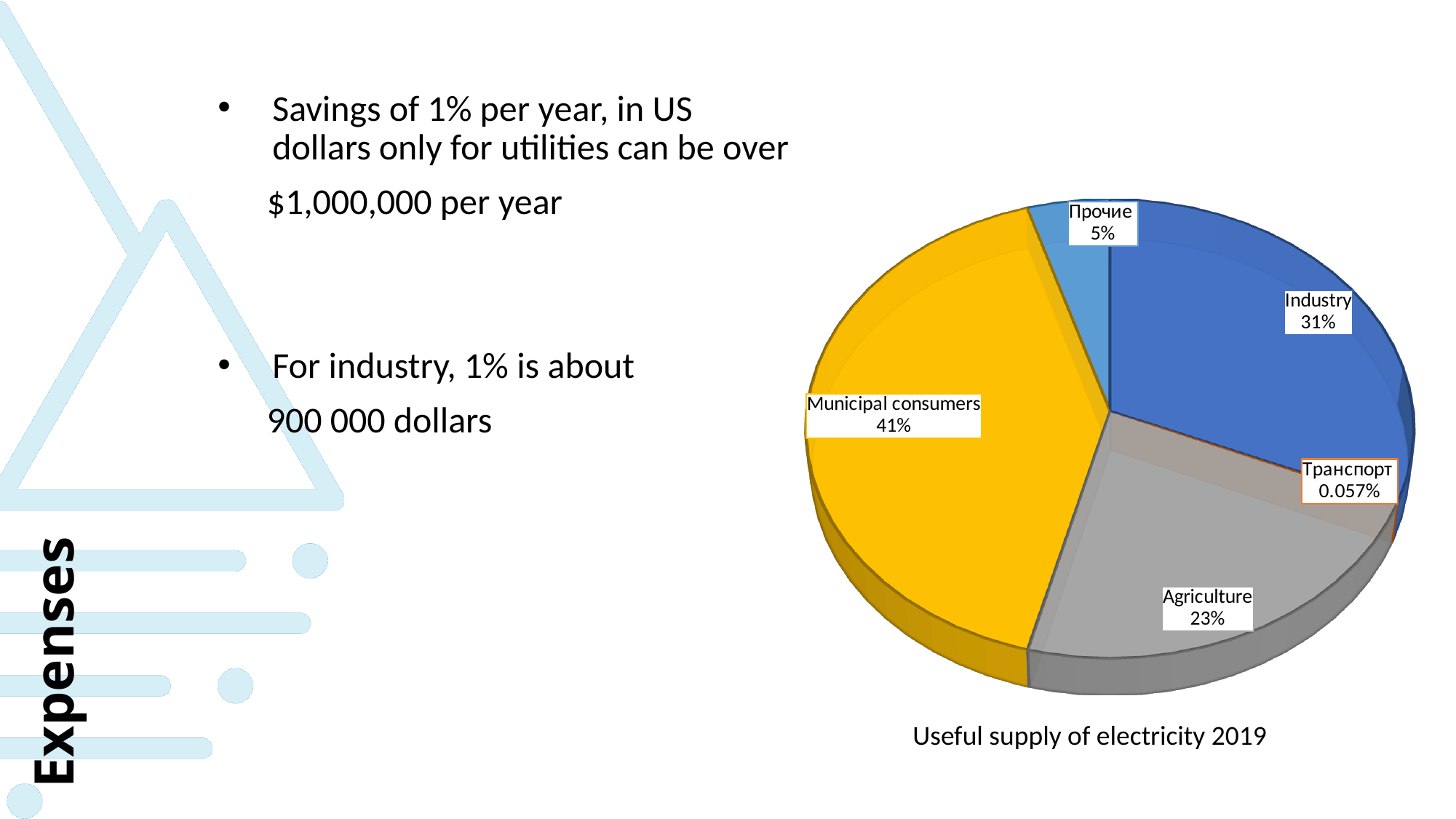
Which is larger, the share for Industry or the share for Agriculture? Industry What is the difference in percentage points between Municipal consumers and Industry? 10 What share of the pie does Прочие have? 5% What kind of chart is shown on the slide? Pie chart What share of the pie does Industry have? 31% What share of the pie does Транспорт have? 0.057% Which category has the smallest share of the pie? Транспорт How many categories are shown in the pie chart? 5 What share of the pie does Municipal consumers have? 41% What share of the pie does Agriculture have? 23% Which category has the largest share of the pie? Municipal consumers What is the caption below the pie chart? Useful supply of electricity 2019